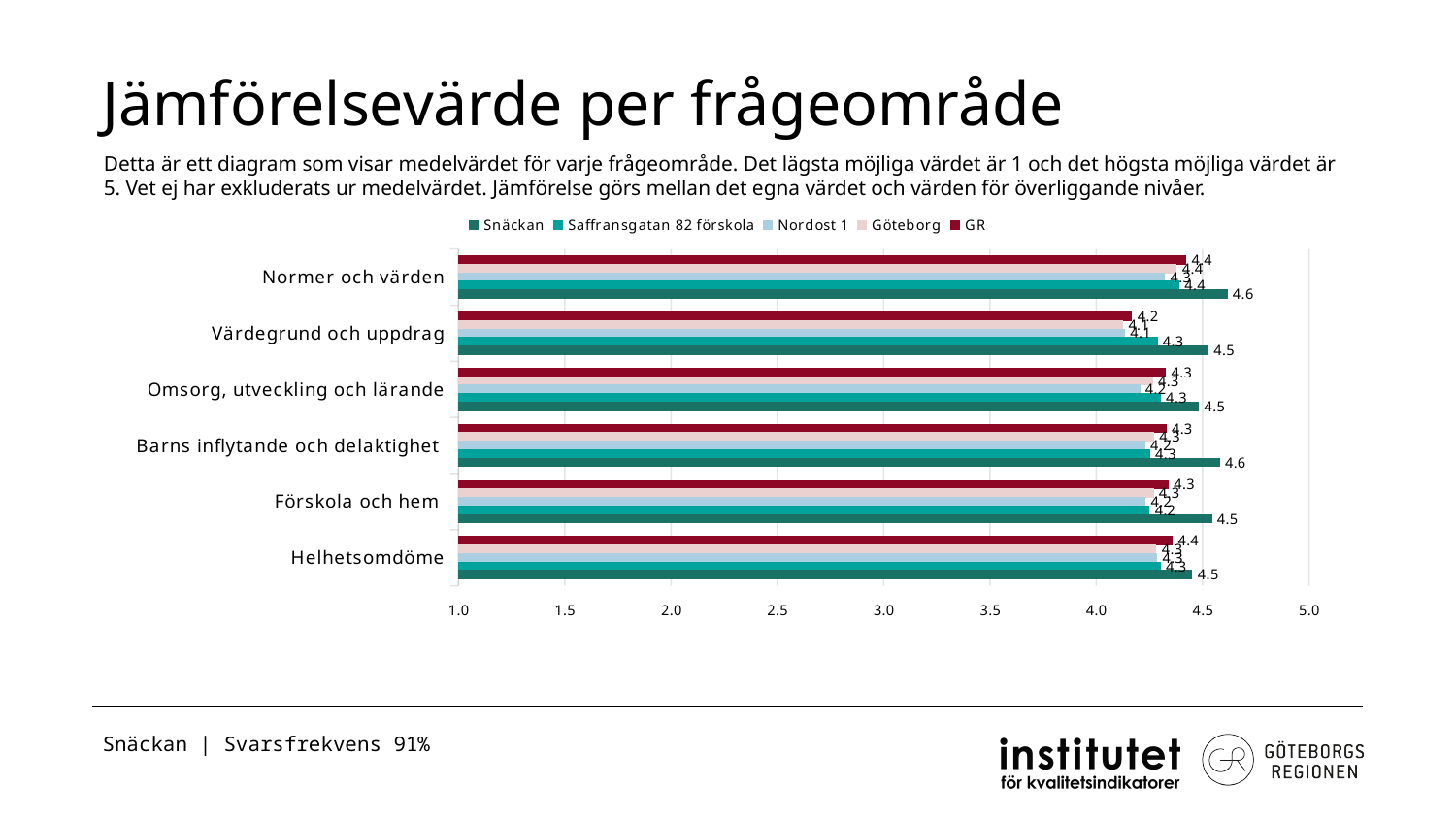
What is the value for Snäckan in Normer och värden? 4.6 Which is larger in Barns inflytande och delaktighet: the value for Snäckan or the value for GR? Snäckan How many question areas (categories) are shown on the y axis? 6 How many series does the legend list? 5 What is the value for Snäckan in Helhetsomdöme? 4.5 Is the value for Snäckan in Förskola och hem greater or less than 4.0? greater What is the difference between the Snäckan value and the GR value in Normer och värden? 0.2 What is the value for GR in Värdegrund och uppdrag? 4.2 What is the value for Snäckan in Värdegrund och uppdrag? 4.5 What is the title of the chart on the slide? Jämförelsevärde per frågeområde What type of chart is shown on the slide? bar chart